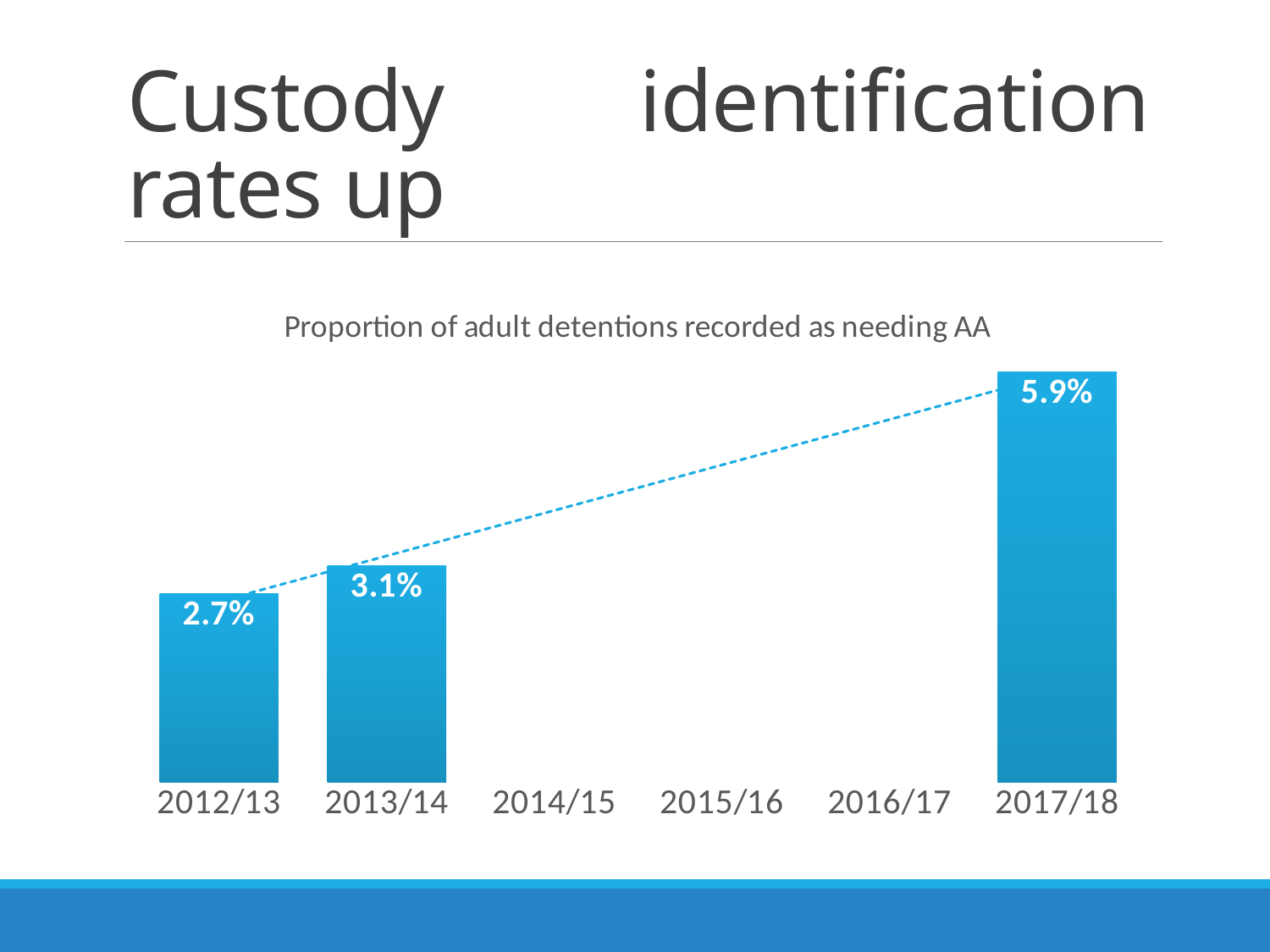
Do the values rise or fall from 2012/13 to 2017/18? Rise Which is larger, the value for 2013/14 or the value for 2017/18? 2017/18 What is the difference between the values for 2013/14 and 2012/13? 0.4 percentage points How many year labels are shown on the x axis? 6 What is the value for 2017/18? 5.9% What is the value for 2012/13? 2.7% How many bars with data labels are plotted on the chart? 3 Which year has the highest proportion of adult detentions recorded as needing AA? 2017/18 Which year has the lowest value shown on the chart? 2012/13 What is the value for 2013/14? 3.1% What kind of chart is shown on the slide? Bar chart What is the difference between the values for 2017/18 and 2012/13? 3.2 percentage points